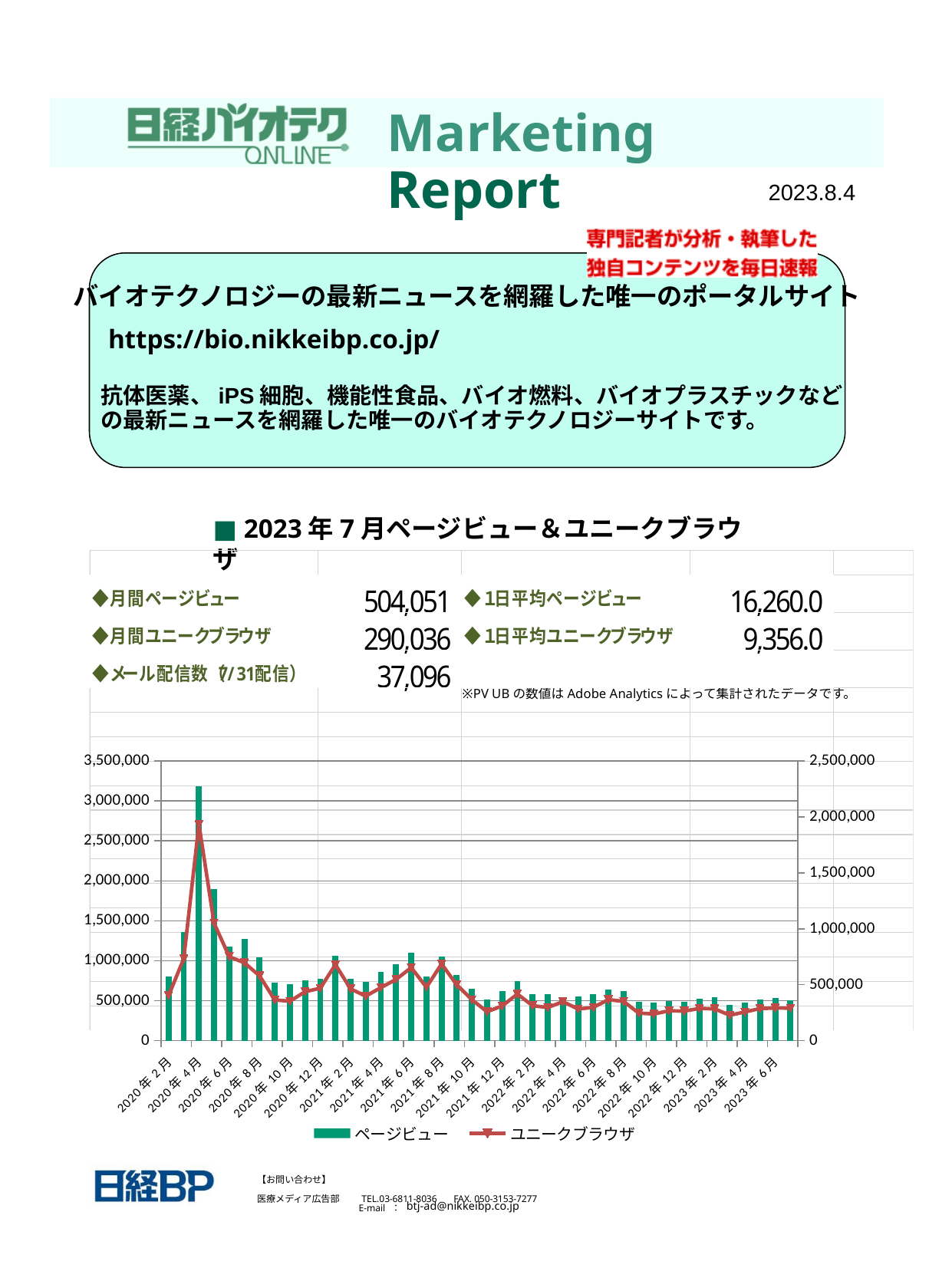
In which month is the ページビュー bar highest? 2020年4月 Is the ユニークブラウザ value for 2020年4月 greater or less than 1,500,000 on the right axis? greater Is the ページビュー value for 2020年4月 greater or less than 3,000,000? greater Which series is drawn as bars in the chart? ページビュー After the peak in 2020年4月, do the ページビュー values generally rise or fall through 2023年6月? fall What kind of chart is shown on the slide? A combined bar and line chart Is the ページビュー value for 2023年6月 greater or less than 1,000,000? less In which month does the ユニークブラウザ line reach its peak? 2020年4月 What are the two series named in the chart legend? ページビュー and ユニークブラウザ How many series does the chart legend list? 2 Which month has the larger ページビュー bar, 2020年4月 or 2020年6月? 2020年4月